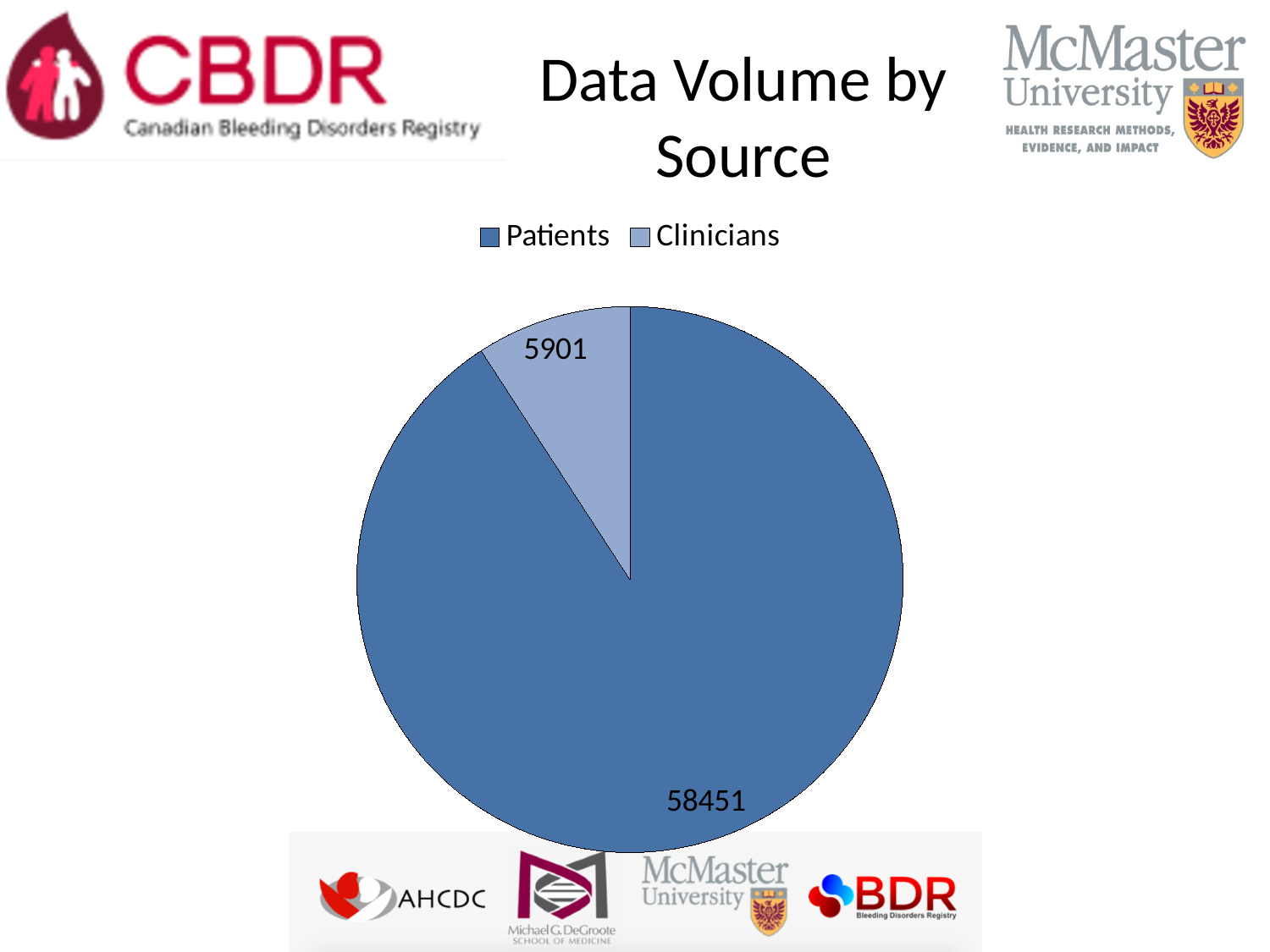
What is the difference between the Patients value and the Clinicians value? 52550 Which source has the smallest slice of the pie? Clinicians How many slices does the pie chart have? 2 What kind of chart is shown on the slide? pie chart Which source has the largest slice of the pie? Patients What is the value for Patients? 58451 Which is larger, the value for Patients or the value for Clinicians? Patients What is the value for Clinicians? 5901 Which legend entry is shown in the lighter blue colour? Clinicians How many series does the legend list? 2 What is the total of the two slices in the pie chart? 64352 What is the title of the chart? Data Volume by Source